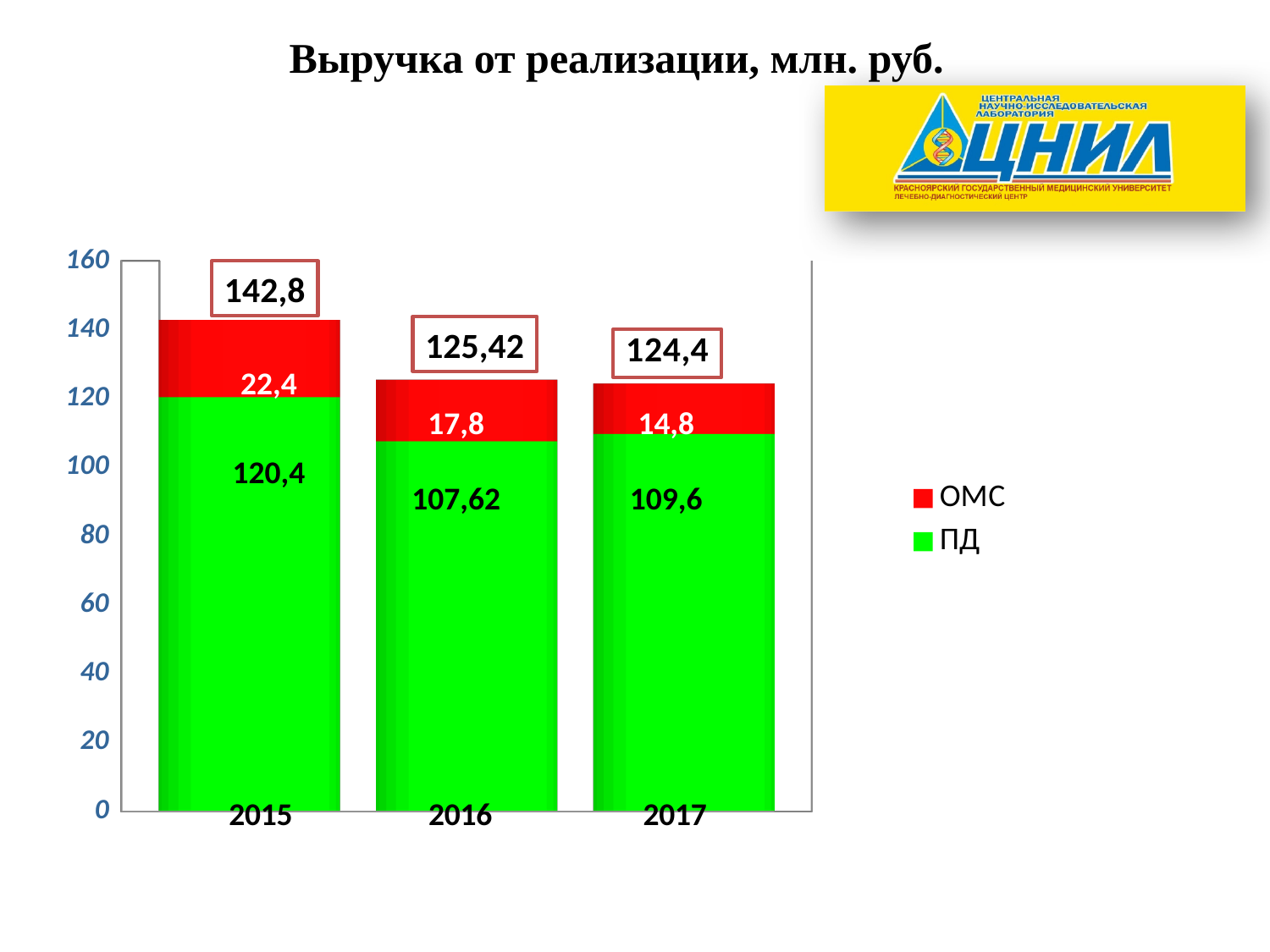
Which colour represents ОМС in the chart? Red What is the total of the stacked bar for 2016? 125,42 Which year has the highest total revenue? 2015 How many series does the legend list? 2 What is the value for ПД in 2017? 109,6 What is the difference between the ОМС values for 2015 and 2017? 7,6 How many years are shown on the x axis? 3 What is the value for ПД in 2015? 120,4 What kind of chart is shown on the slide? Stacked bar chart Which is larger, the ПД value for 2016 or for 2017? 2017 What is the value for ОМС in 2016? 17,8 Which year has the lowest ОМС value? 2017